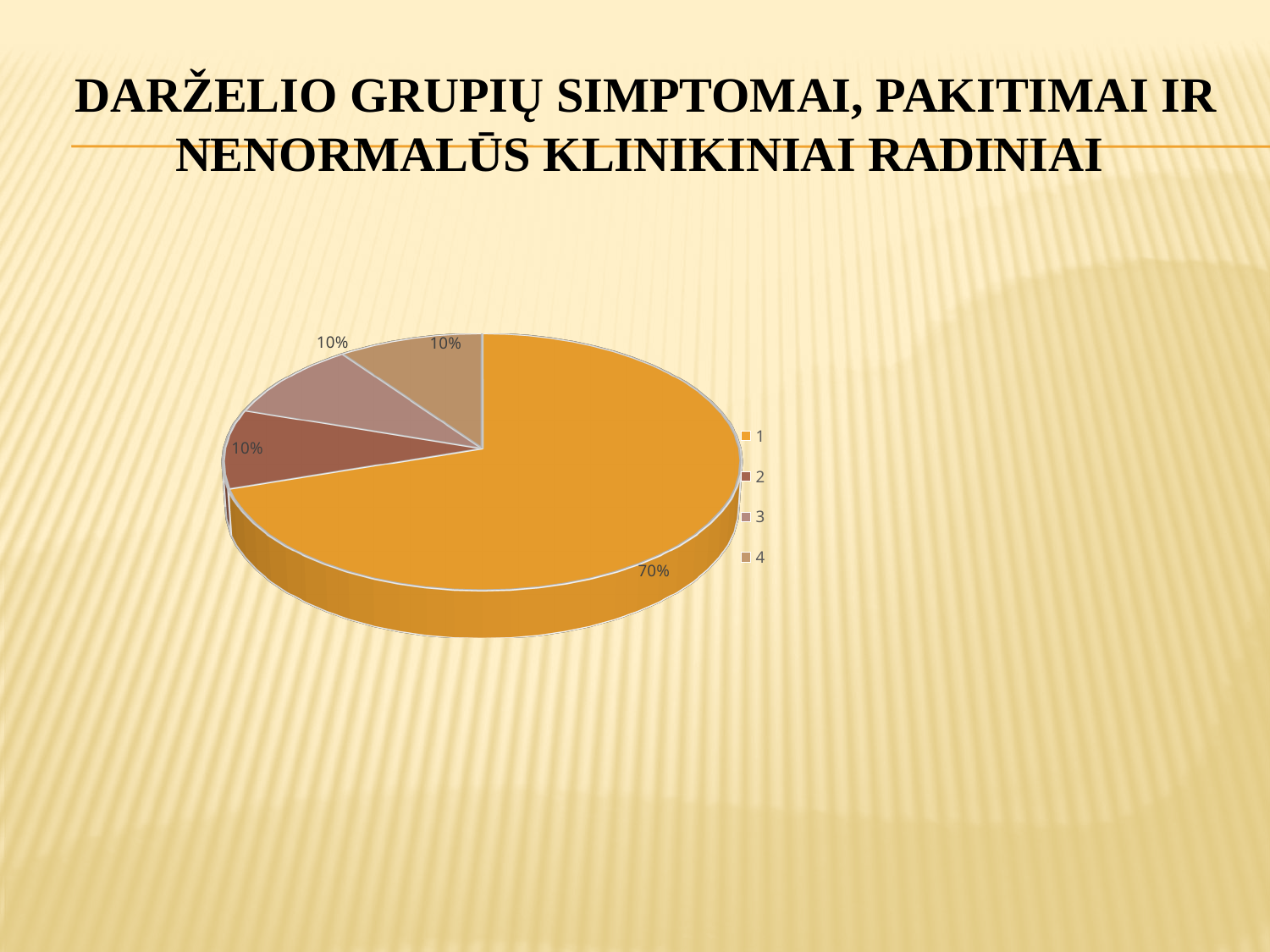
Which is larger, the slice for category 1 or the slice for category 4? category 1 What share of the pie does category 3 have? 10% What share of the pie does category 4 have? 10% What is the title of the slide containing the pie chart? DARŽELIO GRUPIŲ SIMPTOMAI, PAKITIMAI IR NENORMALŪS KLINIKINIAI RADINIAI What is the difference between the share of category 1 and the share of category 2? 60% What share of the pie does category 1 have? 70% Which category has the largest slice of the pie? 1 What kind of chart is shown on the slide? pie chart What are the legend entries of the pie chart? 1, 2, 3, 4 How many slices does the pie chart have? 4 How many entries does the legend of the pie chart list? 4